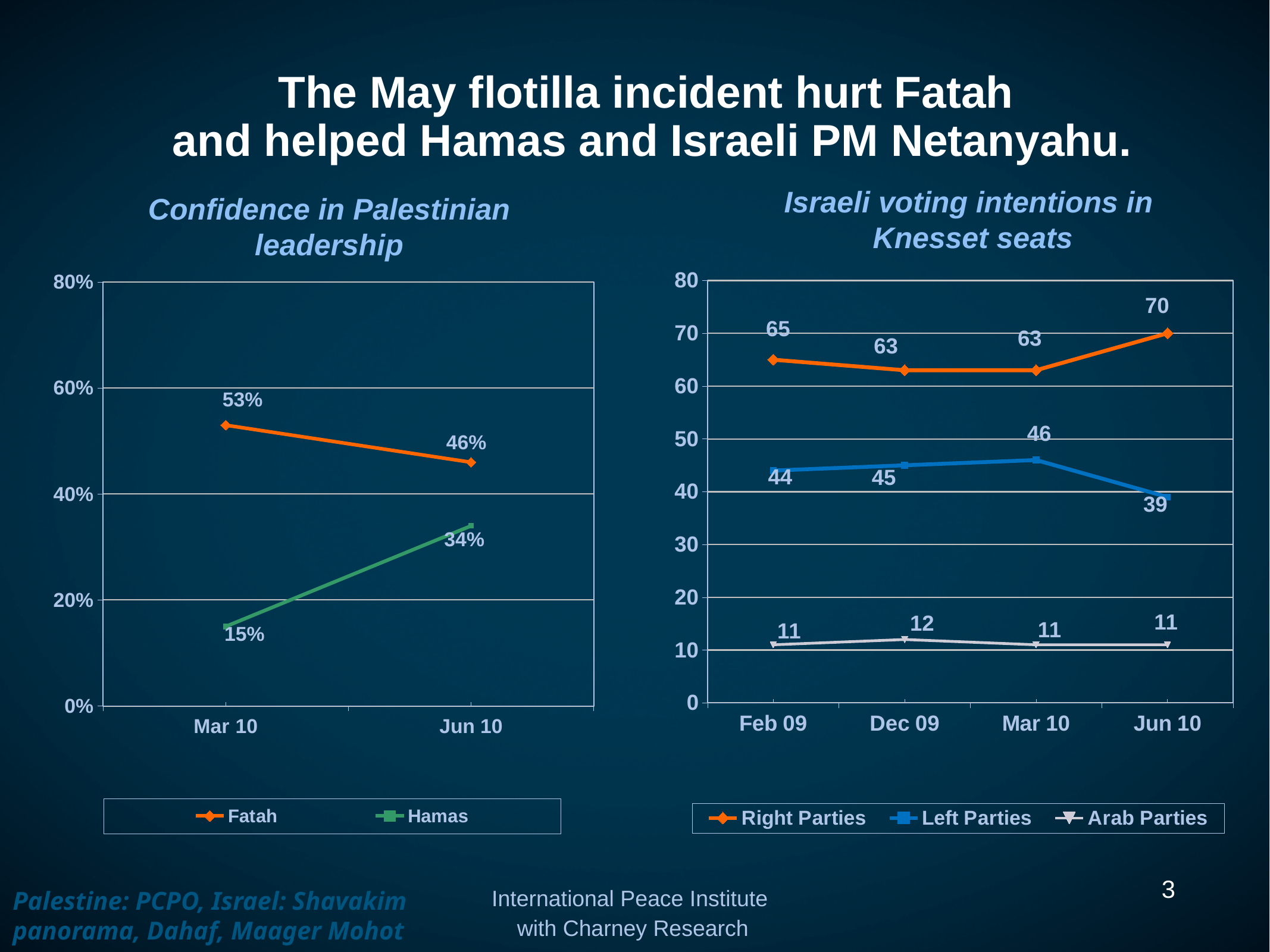
In the 'Israeli voting intentions in Knesset seats' chart, how many time periods are shown on the x axis? 4 In the 'Israeli voting intentions in Knesset seats' chart, what is the difference between Right Parties and Left Parties in Jun 10? 31 In the 'Israeli voting intentions in Knesset seats' chart, which series is shown in orange? Right Parties In the 'Israeli voting intentions in Knesset seats' chart, what is the value for Left Parties in Dec 09? 45 In the 'Confidence in Palestinian leadership' chart, what is the value for Hamas in Mar 10? 15% In the 'Confidence in Palestinian leadership' chart, how many series does the legend list? 2 In the 'Confidence in Palestinian leadership' chart, does the Fatah line rise or fall from Mar 10 to Jun 10? fall In the 'Confidence in Palestinian leadership' chart, by how many percentage points did Hamas rise from Mar 10 to Jun 10? 19 percentage points What type of chart is the 'Israeli voting intentions in Knesset seats' chart? line chart In the 'Israeli voting intentions in Knesset seats' chart, what is the value for Right Parties in Jun 10? 70 In the 'Israeli voting intentions in Knesset seats' chart, in which period do Left Parties reach their highest value? Mar 10 In the 'Confidence in Palestinian leadership' chart, what is the value for Fatah in Jun 10? 46%